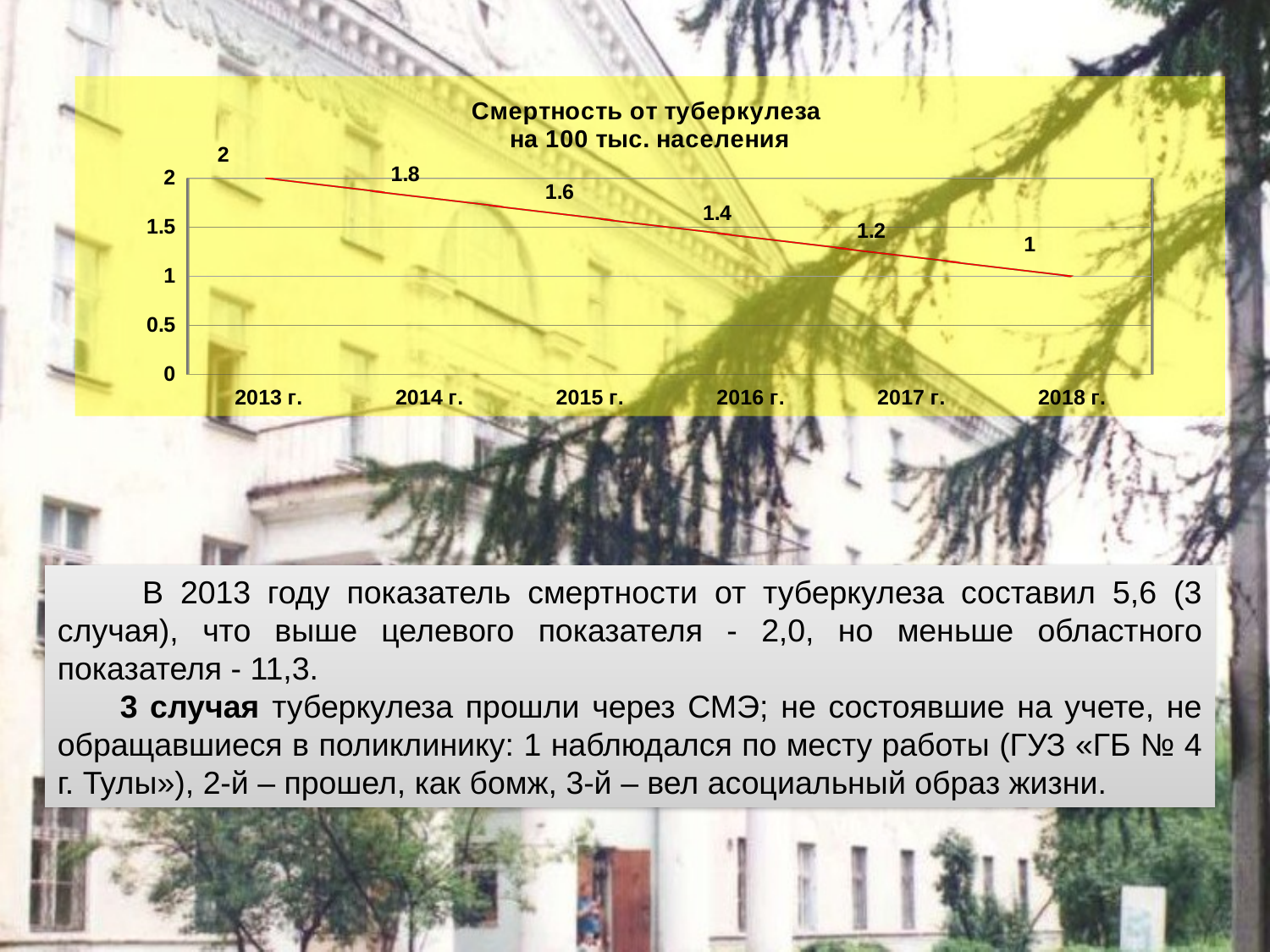
What is the value for 2016 г.? 1.4 What is the value for 2018 г.? 1 Which year has the highest value? 2013 г. What is the difference between the values for 2013 г. and 2018 г.? 1 What is the title of the chart? Смертность от туберкулеза на 100 тыс. населения Is the value for 2015 г. greater or less than 1.5? greater How many years are shown on the x axis? 6 Which year has the lowest value? 2018 г. Do the values rise or fall from 2013 г. to 2018 г.? fall What kind of chart is this? line chart What is the value for 2013 г.? 2 Which is larger, the value for 2014 г. or the value for 2017 г.? 2014 г.